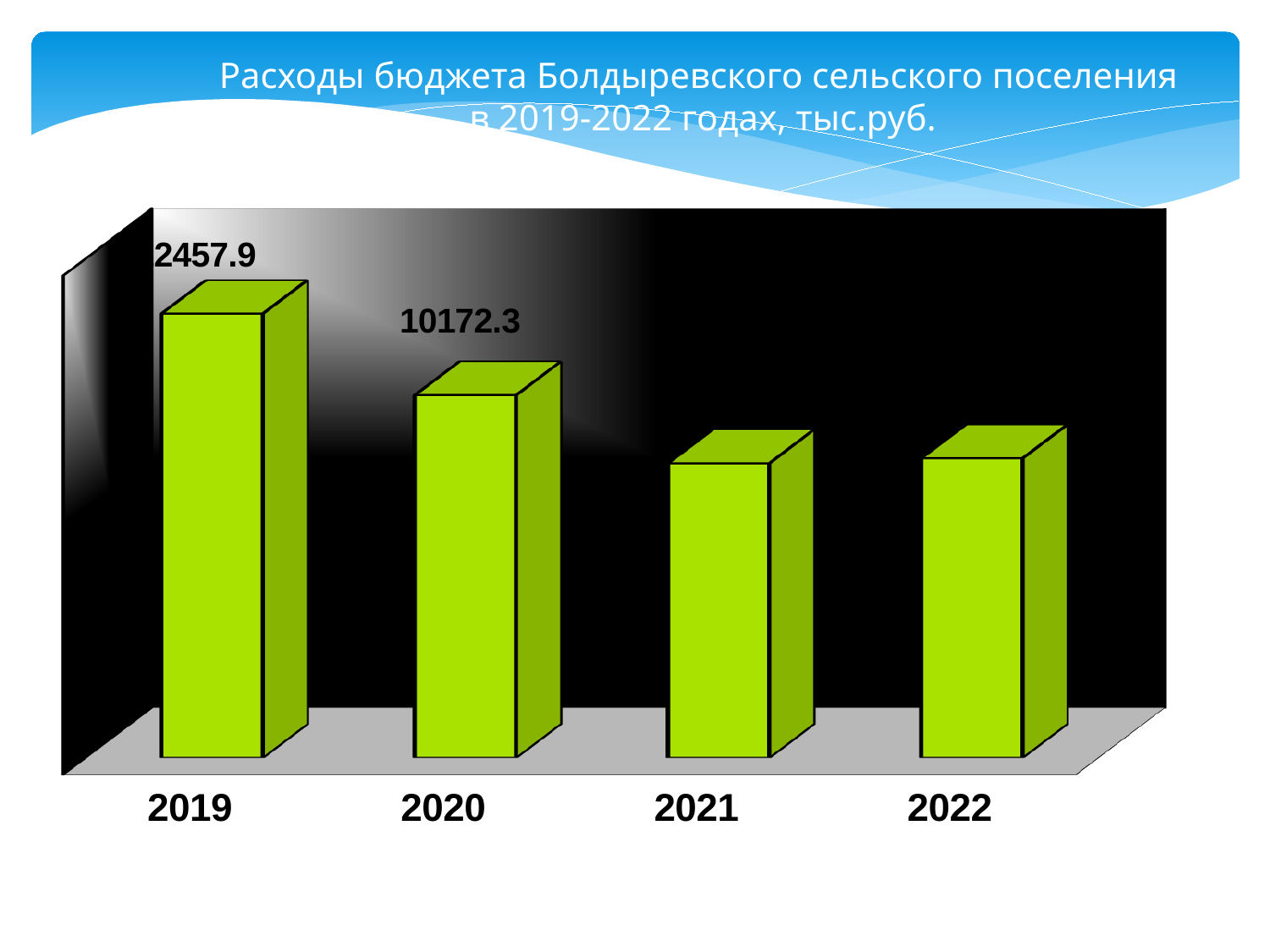
Do the bars get taller or shorter from 2019 to 2022? Shorter What colour are the bars in the chart? Green How many years (bars) are shown on the chart? 4 Which bars on the chart have no data label? 2021 and 2022 Which years are shown on the x axis of the chart? 2019, 2020, 2021, 2022 What is the difference between the labelled values for 2020 and 2019? 7714.4 What kind of chart is shown on the slide? Bar chart What value is shown for 2019? 2457.9 What value is shown for 2020? 10172.3